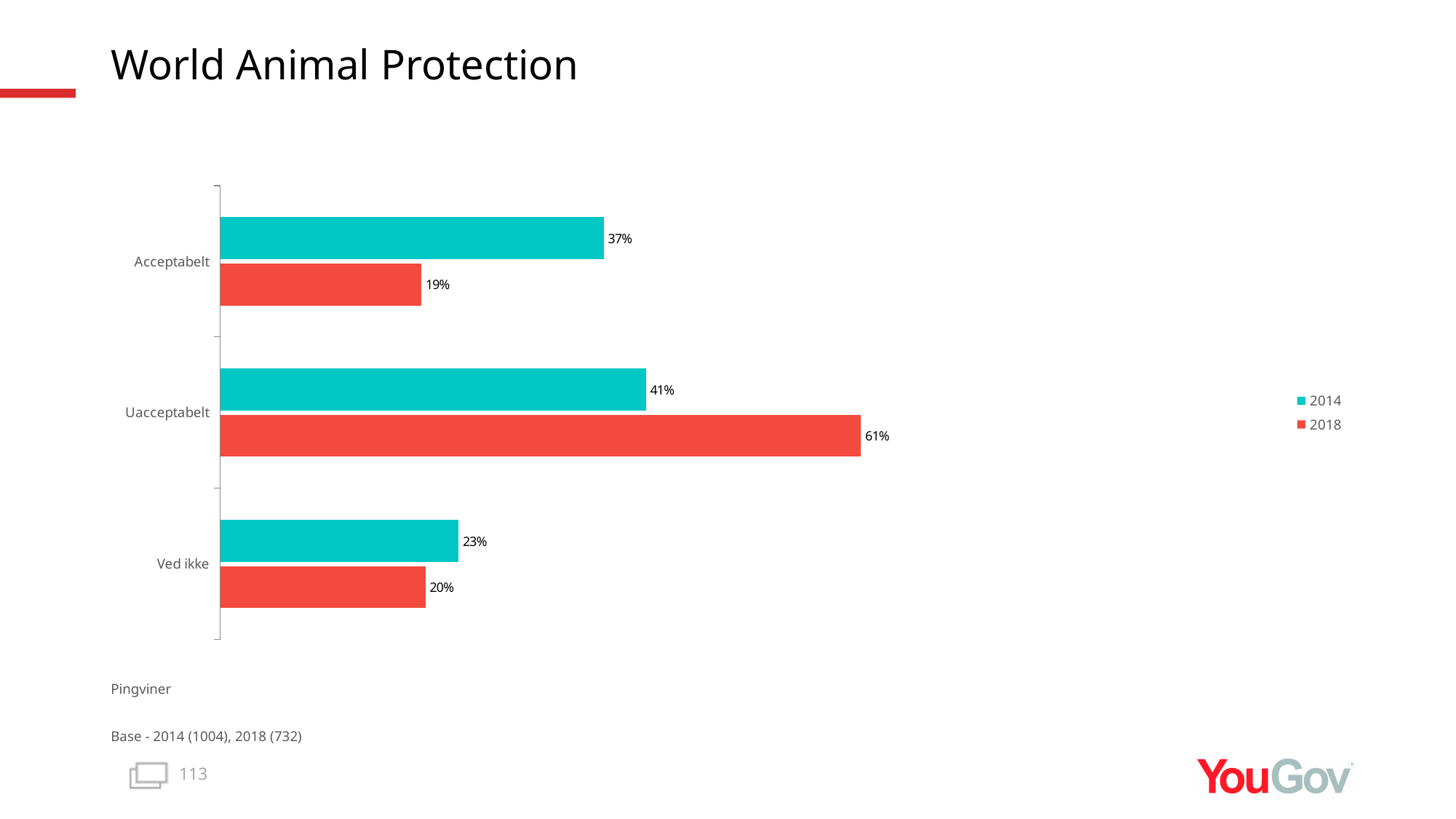
How many categories are shown on the chart? 3 Which category has the highest 2018 value? Uacceptabelt Which category has the lowest 2014 value? Ved ikke What is the 2018 value for Ved ikke? 20% What is the difference between the 2014 and 2018 values for Acceptabelt? 18% Which series is shown in red in the legend? 2018 What kind of chart is shown on the slide? Bar chart What is the 2018 value for Uacceptabelt? 61% How many series does the legend list? 2 What is the 2014 value for Acceptabelt? 37% Which is larger for Ved ikke, the 2014 value or the 2018 value? 2014 What is the difference between the 2018 and 2014 values for Uacceptabelt? 20%